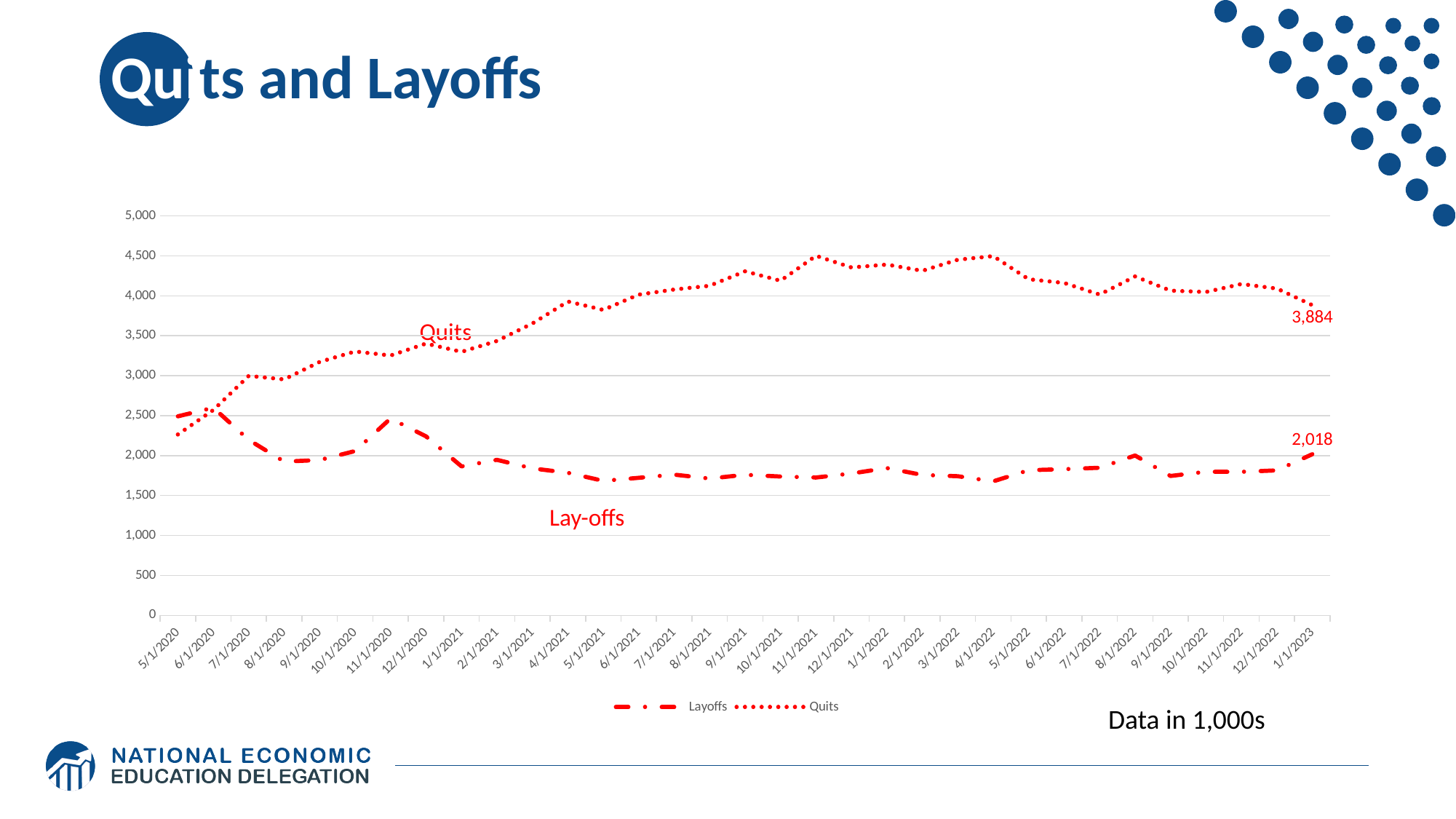
How many monthly data points are plotted along the x axis? 33 Is the value for Quits at 11/1/2021 greater or less than 4,000? greater What unit note is shown below the chart? Data in 1,000s What is the difference between Quits and Layoffs at 1/1/2023? 1,866 At 1/1/2023, which series has the larger value, Quits or Layoffs? Quits Do Quits generally rise or fall from 5/1/2020 to 11/1/2021? Rise What is the value of Quits at 1/1/2023? 3,884 What kind of chart is shown on the slide? Line chart How many series does the legend list? 2 Is the value for Quits at 5/1/2020 greater or less than 3,000? less What is the value of Layoffs at 1/1/2023? 2,018 Is the value for Layoffs at 11/1/2020 greater or less than 2,000? greater